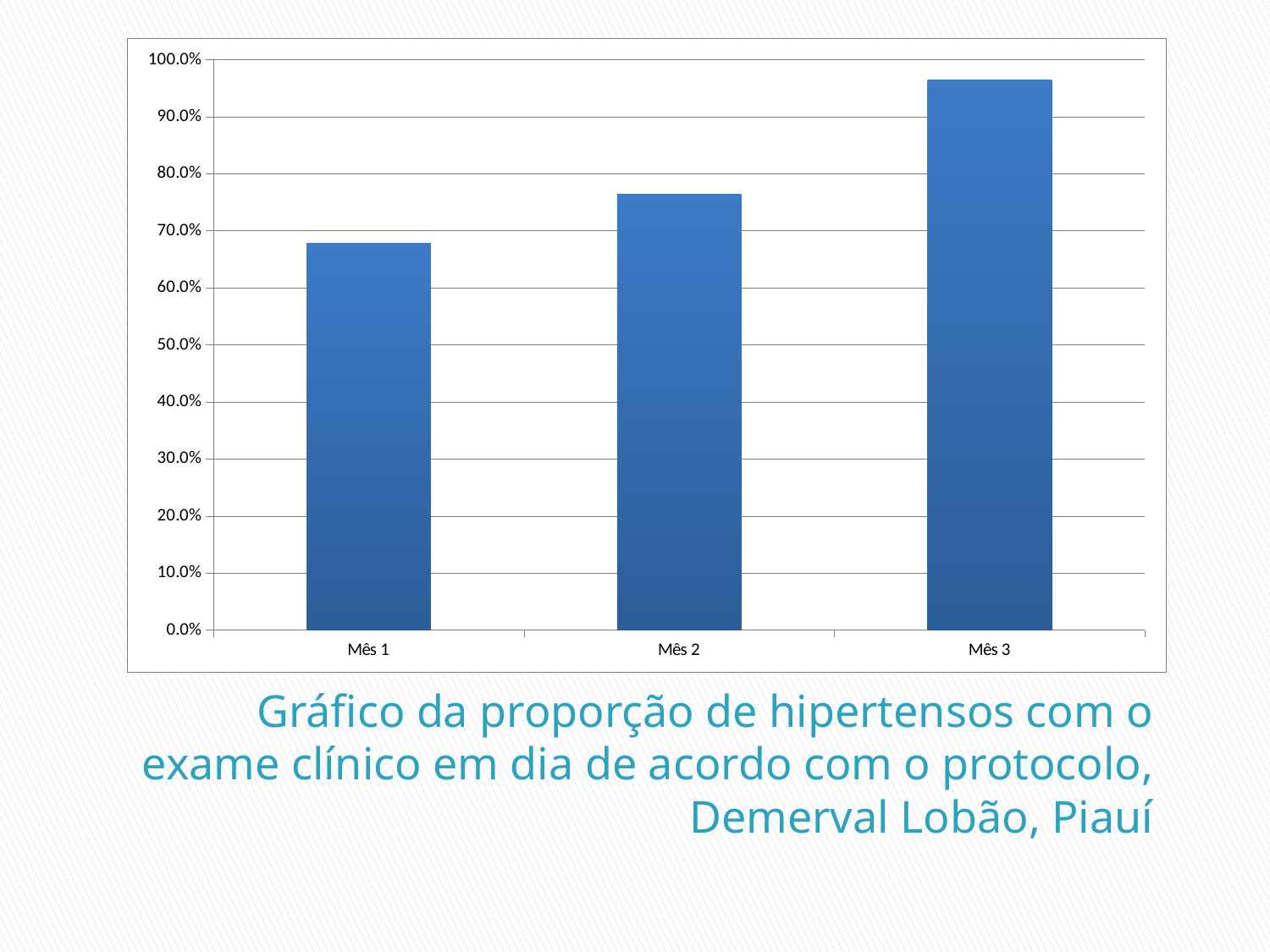
Which is larger, the value for Mês 1 or the value for Mês 2? Mês 2 Which month has the lowest value on the chart? Mês 1 Is the value for Mês 2 greater or less than 80.0%? less What is the maximum value shown on the vertical axis of the chart? 100.0% Do the values rise or fall from Mês 1 to Mês 3? rise According to the caption below the chart, which municipality and state does the chart refer to? Demerval Lobão, Piauí Is the value for Mês 3 greater or less than 90.0%? greater How many categories (months) are plotted on the chart? 3 Is the value for Mês 2 greater or less than 70.0%? greater Which month has the highest value on the chart? Mês 3 What kind of chart is shown on the slide? bar chart